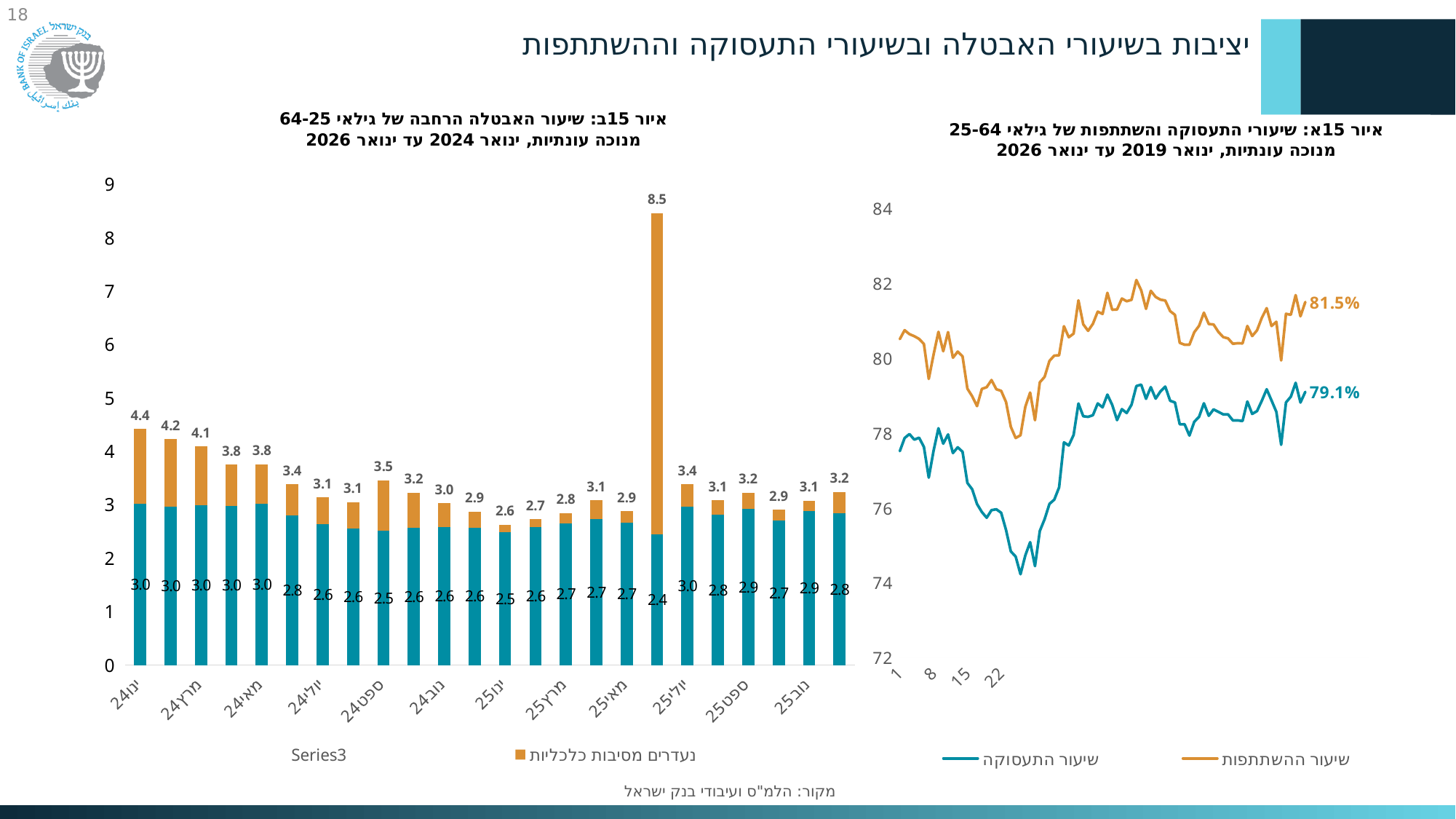
In the left chart (איור 15ב), what is the value of the teal (Series3) segment for ינו24? 3.0 In the right chart (איור 15א), is the lowest point of the שיעור התעסוקה line greater or less than 76? less What kind of chart is the right chart (איור 15א)? line chart In the left chart (איור 15ב), which bar has a larger total, ינו24 or מרץ24? ינו24 What kind of chart is the left chart (איור 15ב)? bar chart In the right chart (איור 15א), what is the final labelled value of שיעור ההשתתפות? 81.5% In the left chart (איור 15ב), what is the highest total value labelled above a bar? 8.5 In the left chart (איור 15ב), what is the total value of the bar for ינו24? 4.4 In the left chart (איור 15ב), what is the lowest total value labelled above a bar? 2.6 In the right chart (איור 15א), what is the final labelled value of שיעור התעסוקה? 79.1% In the left chart (איור 15ב), how many series does the legend list? 2 In the left chart (איור 15ב), what is the difference between the highest bar total (8.5) and the ינו24 total (4.4)? 4.1